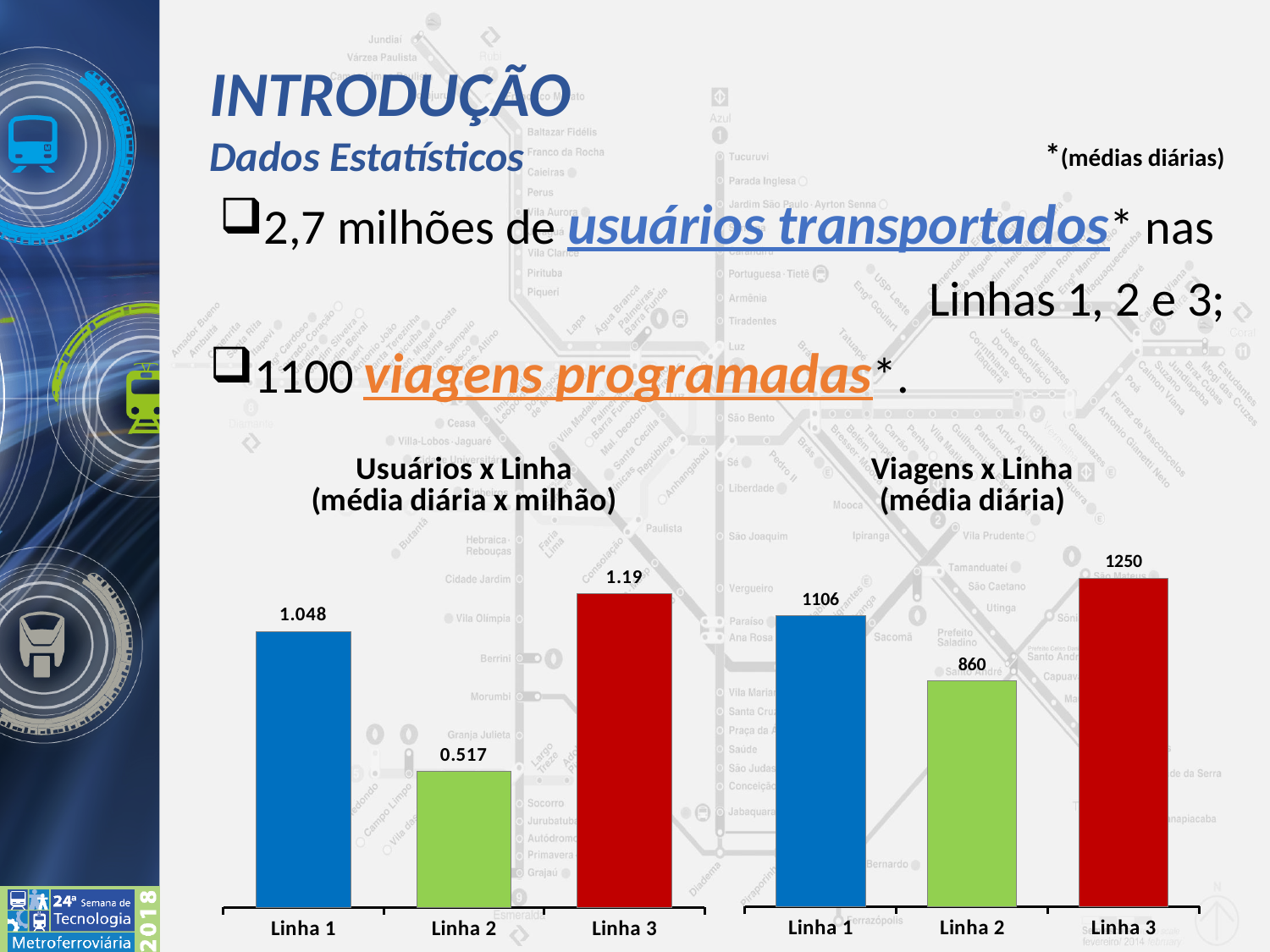
What type of chart is the 'Viagens x Linha' chart? Bar chart In the 'Usuários x Linha' chart, what is the difference between Linha 1 and Linha 2? 0.531 In the 'Viagens x Linha' chart, what is the value for Linha 2? 860 In the 'Viagens x Linha' chart, what colour is the bar for Linha 2? Green In the 'Usuários x Linha' chart, what is the value for Linha 2? 0.517 In the 'Usuários x Linha' chart, what is the value for Linha 1? 1.048 In the 'Viagens x Linha' chart, which line has the lowest value? Linha 2 In the 'Viagens x Linha' chart, what is the value for Linha 3? 1250 In the 'Viagens x Linha' chart, what is the difference between Linha 3 and Linha 2? 390 In the 'Usuários x Linha' chart, which line has the highest value? Linha 3 In the 'Viagens x Linha' chart, which is larger, Linha 1 or Linha 3? Linha 3 How many lines (categories) are shown in the 'Usuários x Linha' chart? 3